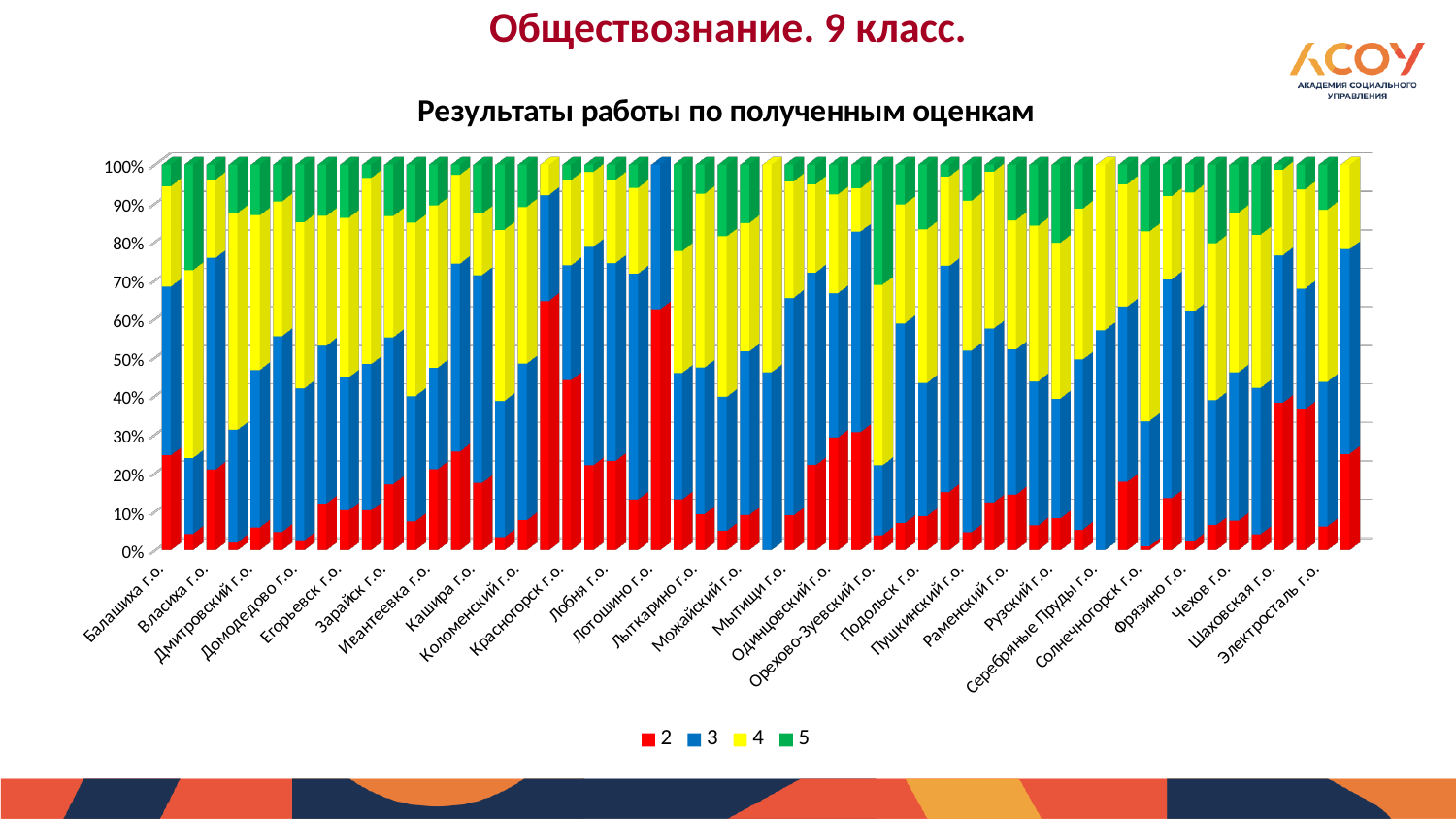
Is the share of grade 2 for Балашиха г.о. greater or less than 40%? less What is the title of the chart? Результаты работы по полученным оценкам Is the share of grade 2 for Балашиха г.о. greater or less than 20%? greater What is the maximum value shown on the vertical axis? 100% Is the share of grade 2 for Электросталь г.о. greater or less than 20%? less Which series is shown in red? 2 What are the series names listed in the legend? 2, 3, 4, 5 How many series does the legend list? 4 What kind of chart is shown on the slide? Stacked bar chart